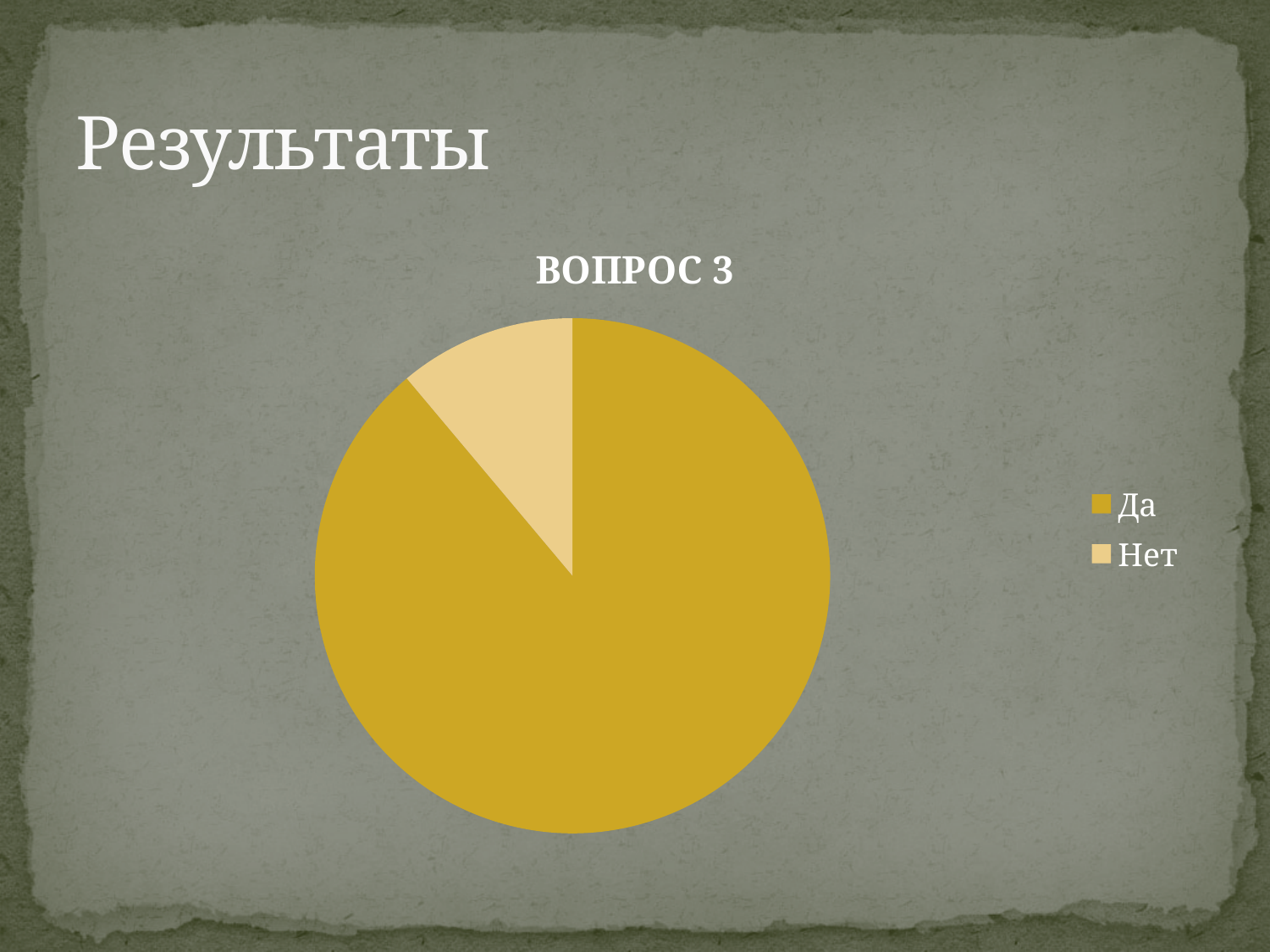
What is the title of the chart? ВОПРОС 3 Which category has the largest slice of the pie? Да How many slices does the pie chart have? 2 What are the two categories listed in the legend? Да, Нет How many entries does the legend list? 2 Which category has the smallest slice of the pie? Нет What kind of chart is shown on the slide? pie chart Which slice is larger, Да or Нет? Да